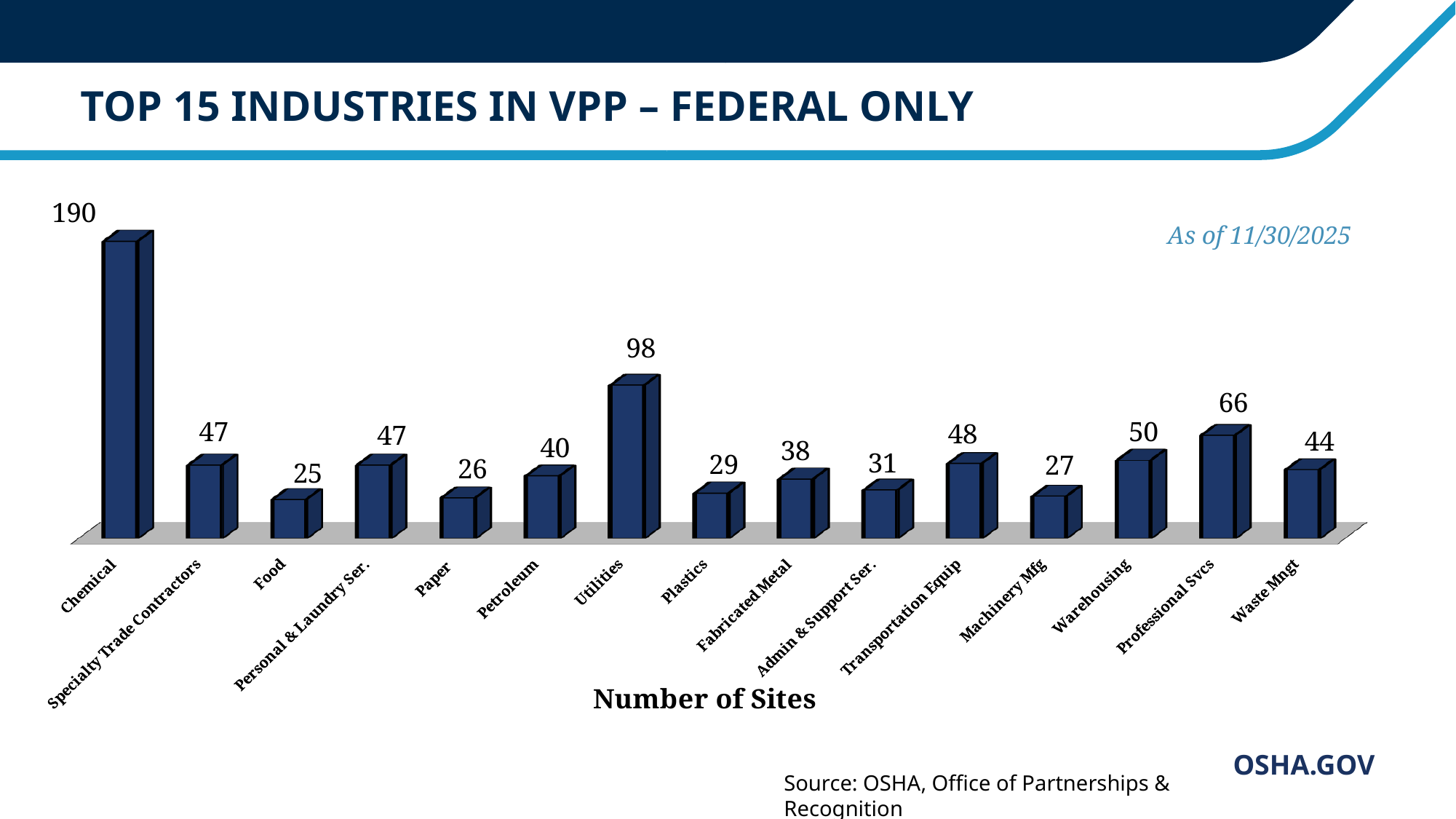
Which industry has the highest number of sites? Chemical What is the number of sites for Machinery Mfg? 27 What is the difference in number of sites between Warehousing and Waste Mngt? 6 What kind of chart is shown on the slide? Bar chart What is the difference in number of sites between Chemical and Utilities? 92 What is the title of the chart on the slide? TOP 15 INDUSTRIES IN VPP – FEDERAL ONLY What is the number of sites for Chemical? 190 What is the number of sites for Professional Svcs? 66 Which industry has the lowest number of sites? Food Which has more sites, Petroleum or Fabricated Metal? Petroleum What is the number of sites for Utilities? 98 How many industries are shown in the chart? 15